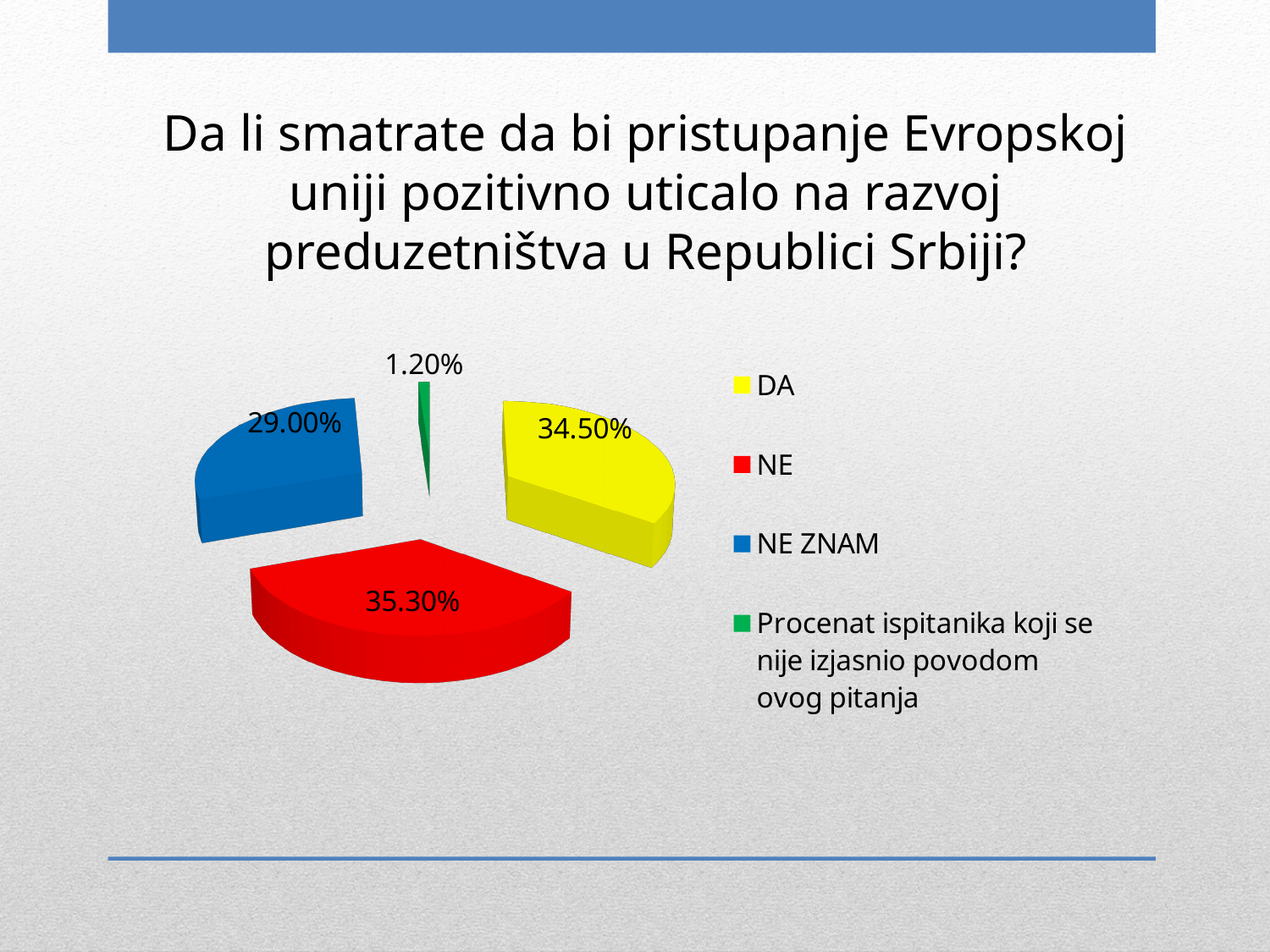
What percentage of respondents answered NE? 35.30% What is the difference in percentage points between DA and NE ZNAM? 5.50% What is the difference in percentage points between NE and DA? 0.80% What colour is the slice for NE ZNAM? blue Which category has the largest share of the pie? NE What percentage of respondents answered NE ZNAM? 29.00% How many slices does the pie chart have? 4 Which is larger, the share for DA or the share for NE ZNAM? DA What percentage of respondents answered DA? 34.50% What kind of chart is shown on the slide? pie chart Which category has the smallest share of the pie? Procenat ispitanika koji se nije izjasnio povodom ovog pitanja What percentage is shown for the green slice (respondents who did not answer the question)? 1.20%